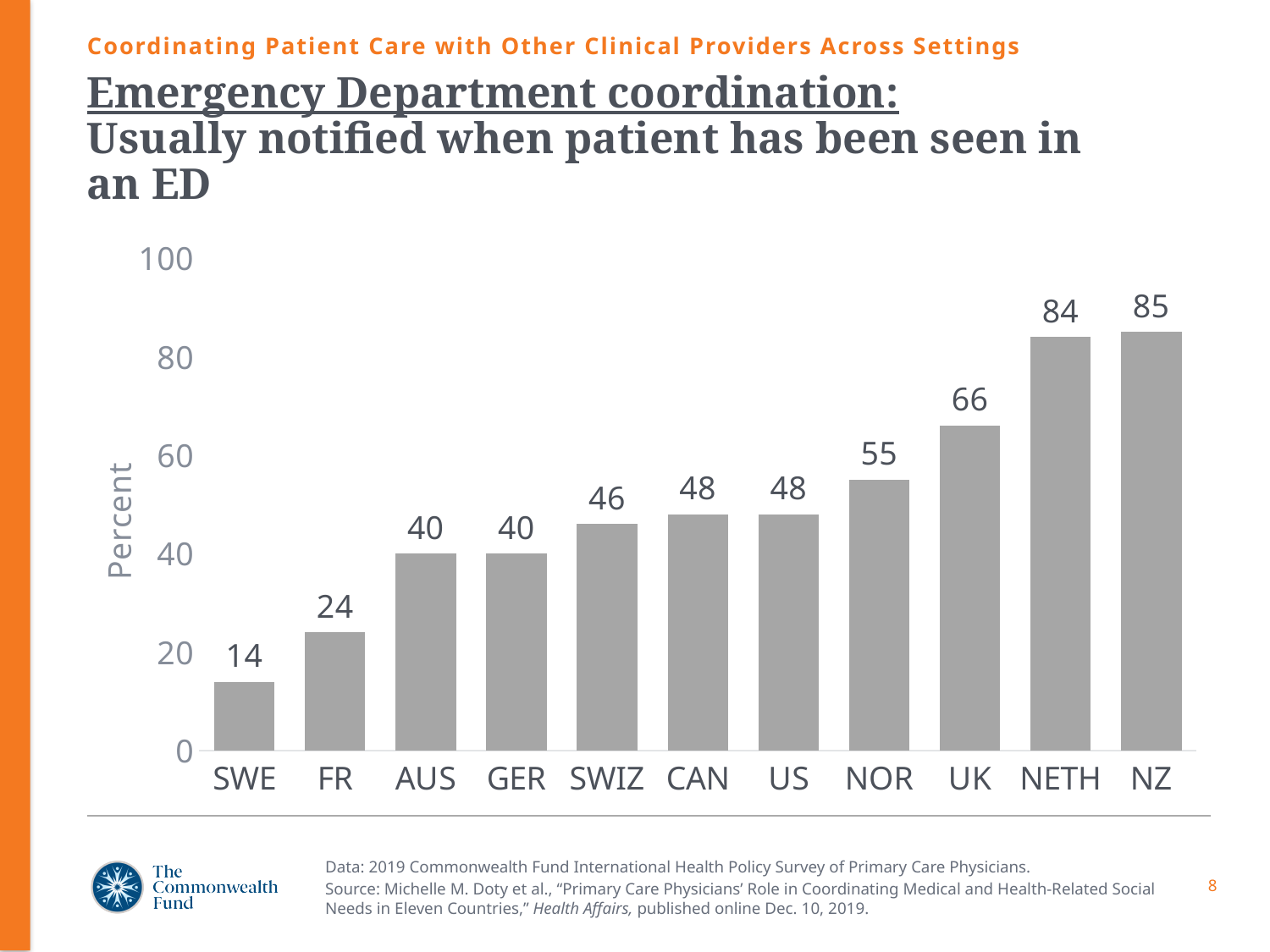
Which country has the lowest value? SWE Which country has the highest value? NZ How many countries are shown on the x axis? 11 What is the value for SWE? 14 What is the value for NOR? 55 What is the label on the y axis? Percent What is the difference between the values for NETH and FR? 60 Do the values generally rise or fall from left to right along the x axis? rise Is the value for GER greater or less than 60? less Which is larger, the value for SWIZ or the value for NOR? NOR What kind of chart is shown on the slide? bar chart What is the value for UK? 66